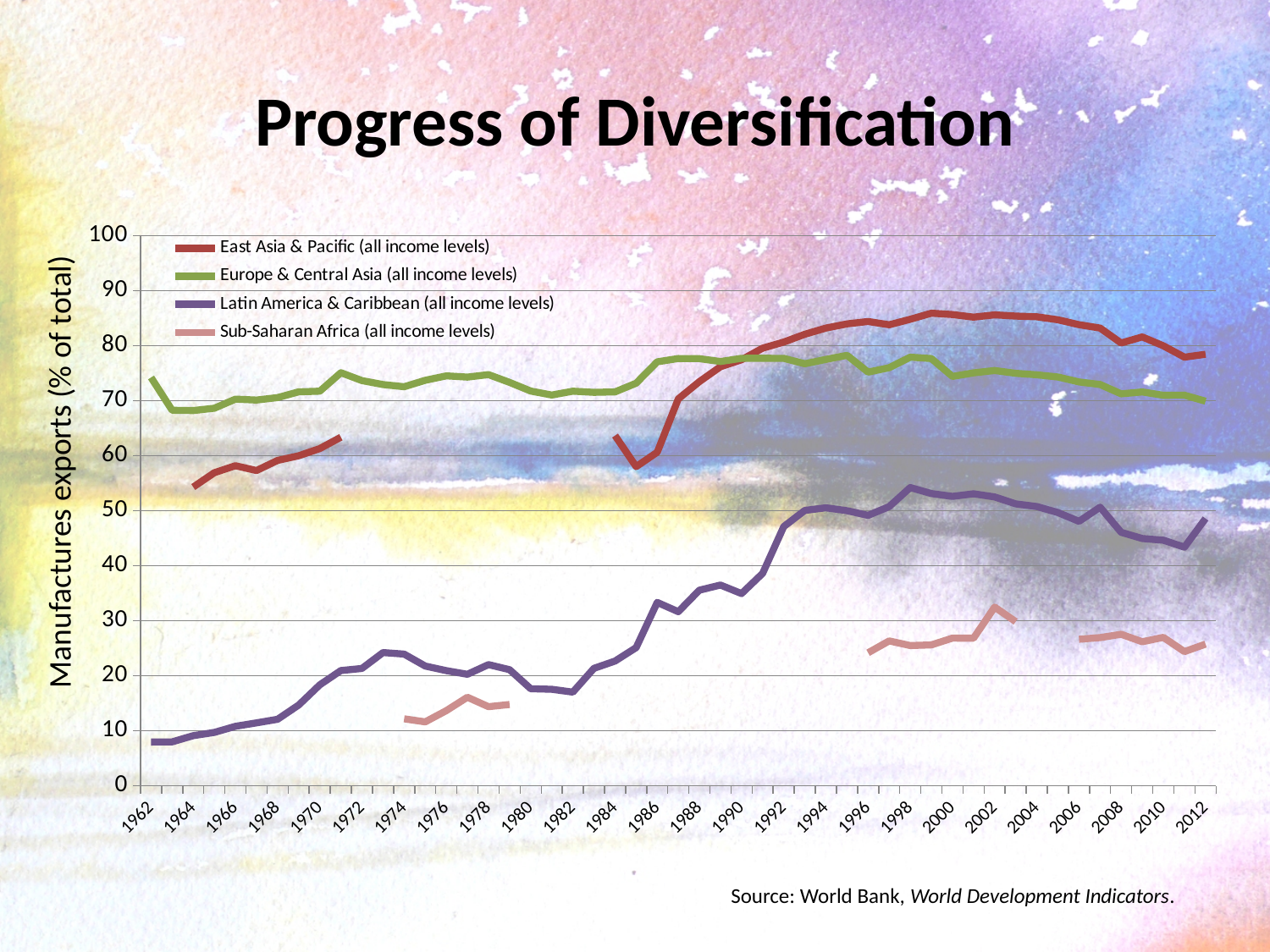
Which series has the lowest value in 2012? Sub-Saharan Africa (all income levels) Is the value for East Asia & Pacific in 2000 greater or less than 80? greater What is the title of the chart? Progress of Diversification Does the Latin America & Caribbean line rise or fall from 1962 to 1998? rise What kind of chart is shown on the slide? line chart Is the value for Europe & Central Asia in 1962 greater or less than 70? greater What is the label on the vertical axis? Manufactures exports (% of total) How many series does the legend list? 4 Is the value for Sub-Saharan Africa in 2002 greater or less than 30? greater Which series has the highest value in 2012? East Asia & Pacific (all income levels) In 1970, which is higher: Europe & Central Asia or East Asia & Pacific? Europe & Central Asia